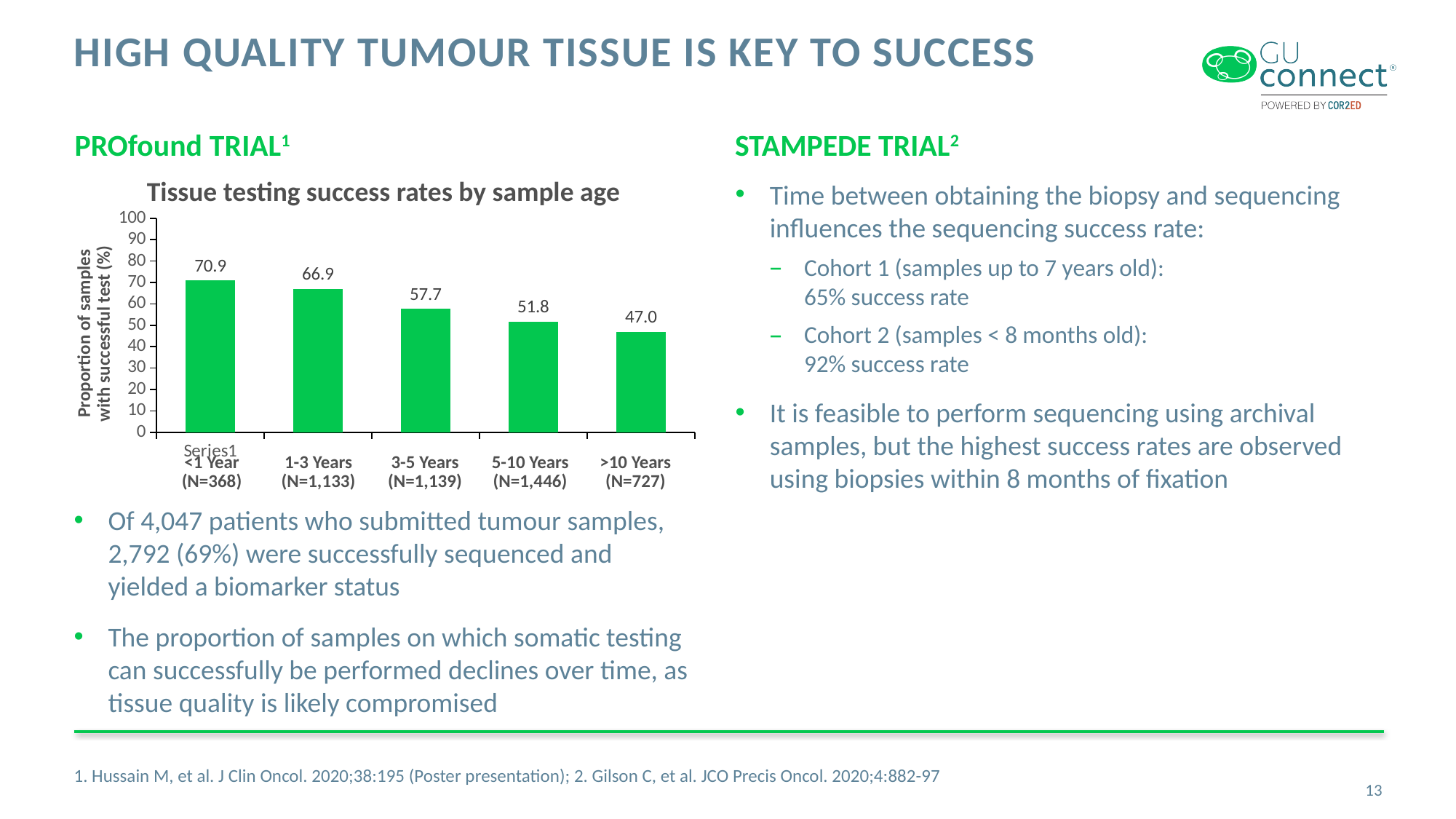
Which has a higher success rate: 3-5 Years or 5-10 Years? 3-5 Years Which sample age category has the lowest tissue testing success rate? >10 Years (N=727) What is the title of the chart? Tissue testing success rates by sample age What is the tissue testing success rate for samples aged >10 Years (N=727)? 47.0 What is the tissue testing success rate for samples aged 3-5 Years (N=1,139)? 57.7 What type of chart is used to show tissue testing success rates by sample age? Bar chart Do the success rates rise or fall as sample age increases along the x axis? Fall Which sample age category has the highest tissue testing success rate? <1 Year (N=368) What is the tissue testing success rate for samples aged 1-3 Years (N=1,133)? 66.9 What is the difference in success rate between the <1 Year and >10 Years categories? 23.9 How many sample age categories are shown in the chart? 5 What is the tissue testing success rate for samples aged <1 Year (N=368)? 70.9